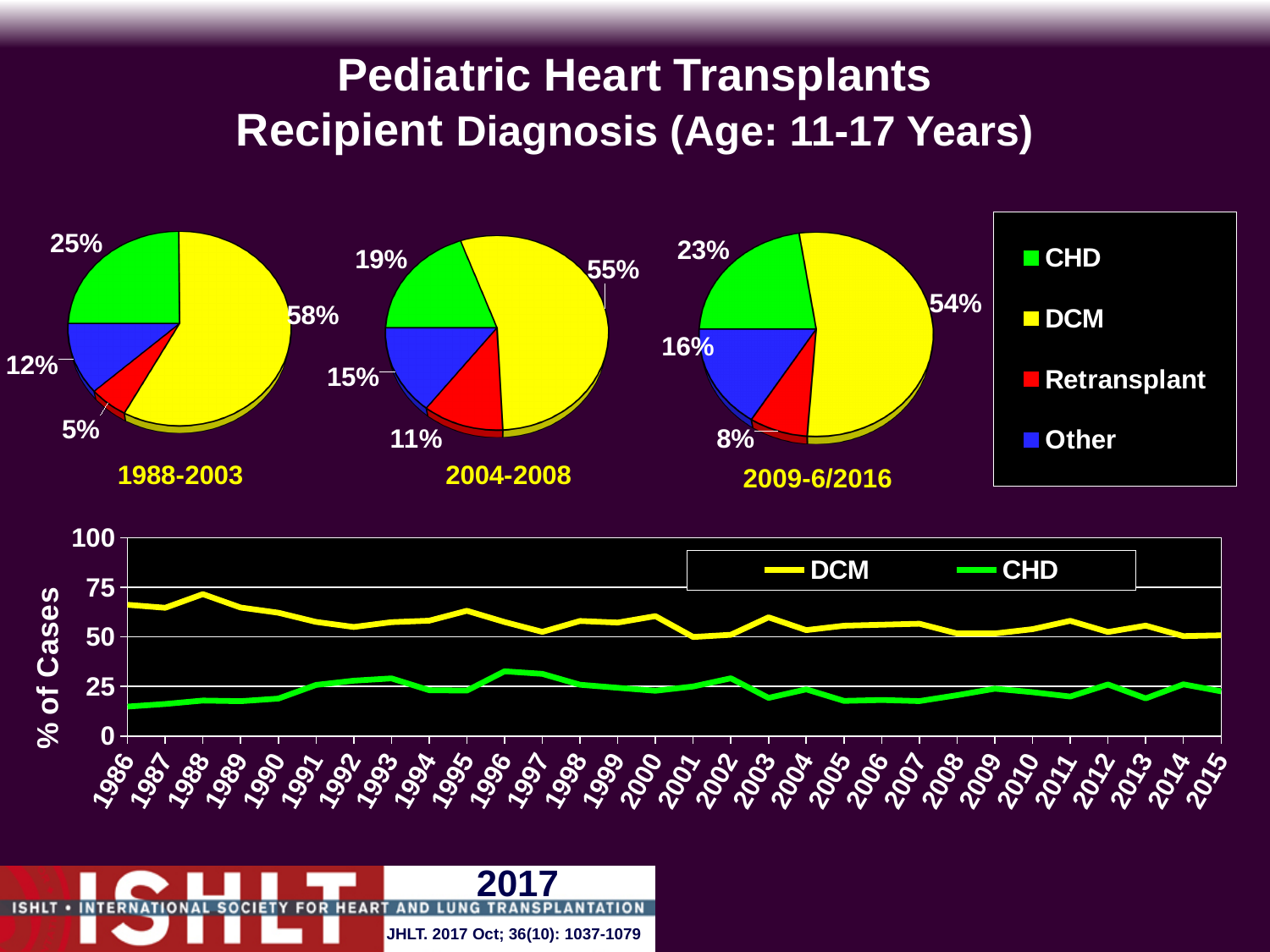
In the 2009-6/2016 pie chart, which diagnosis has the largest share? DCM What kind of chart is the chart at the bottom of the slide showing % of Cases by year? Line chart Is the CHD share larger in the 1988-2003 pie chart or in the 2009-6/2016 pie chart? 1988-2003 In the 2004-2008 pie chart, what share of cases is Retransplant? 11% How many series does the legend for the pie charts list? 4 In the 2009-6/2016 pie chart, what share of cases is Other? 16% In the 1988-2003 pie chart, which diagnosis has the smallest share? Retransplant In the 2004-2008 pie chart, what is the difference between the CHD share and the Other share? 4% In the bottom line chart, does the DCM line generally rise or fall from 1986 to 2015? Fall In the bottom line chart, is the DCM value for 1988 greater or less than 50? greater In the 1988-2003 pie chart, what share of cases is DCM? 58% In the bottom line chart, is the CHD value for 1986 greater or less than 25? less